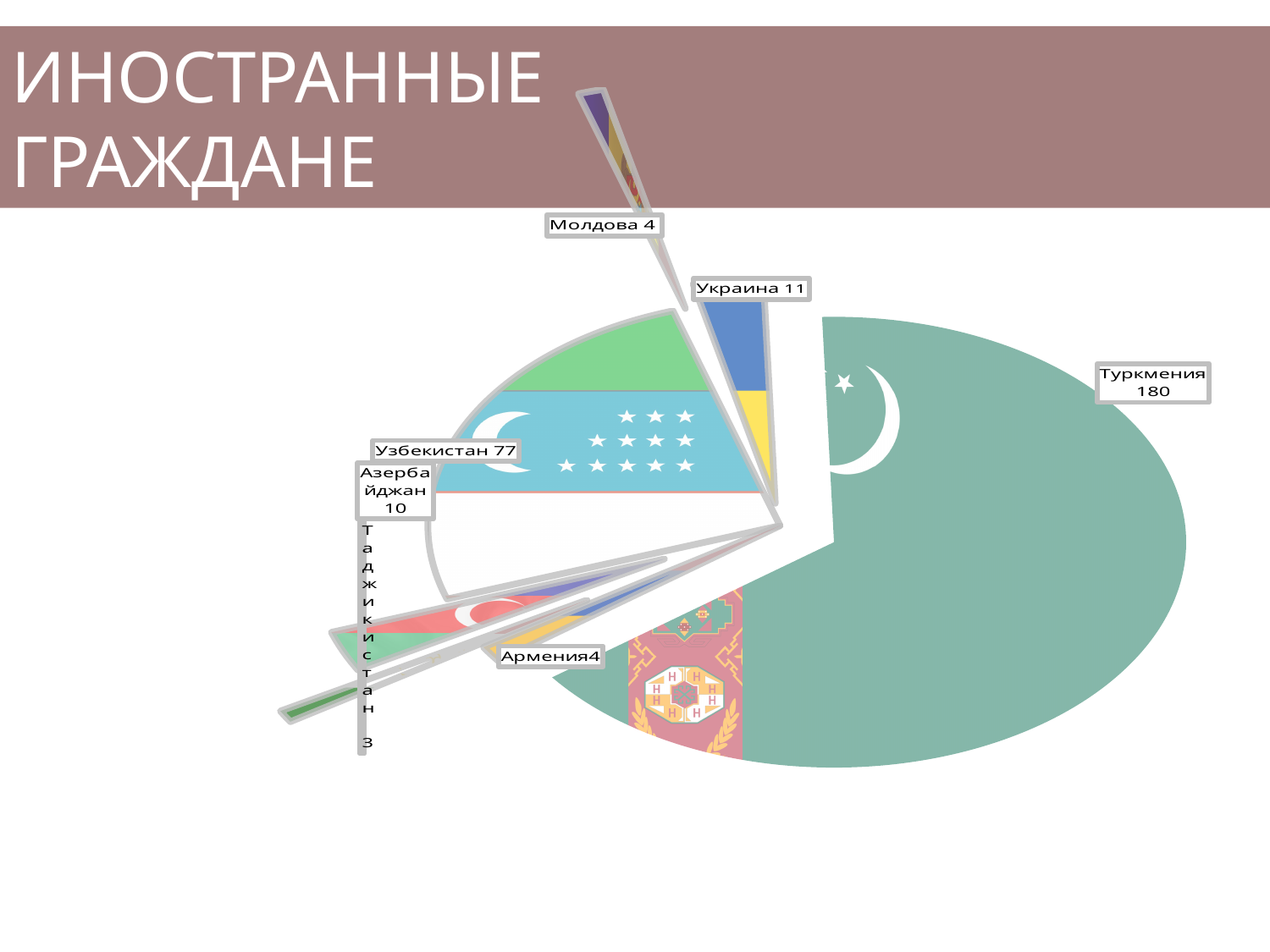
What is the value for Азербайджан? 10 How many countries are shown in the pie chart? 7 Which country has the largest slice of the pie? Туркмения Which is larger, the value for Украина or the value for Азербайджан? Украина What kind of chart is shown on the slide? pie chart What is the title of the slide containing the chart? ИНОСТРАННЫЕ ГРАЖДАНЕ Which country has the smallest value in the chart? Таджикистан What is the value for Украина? 11 What is the difference between the values for Туркмения and Узбекистан? 103 What is the value for Туркмения? 180 What is the value for Узбекистан? 77 What is the value for Таджикистан? 3